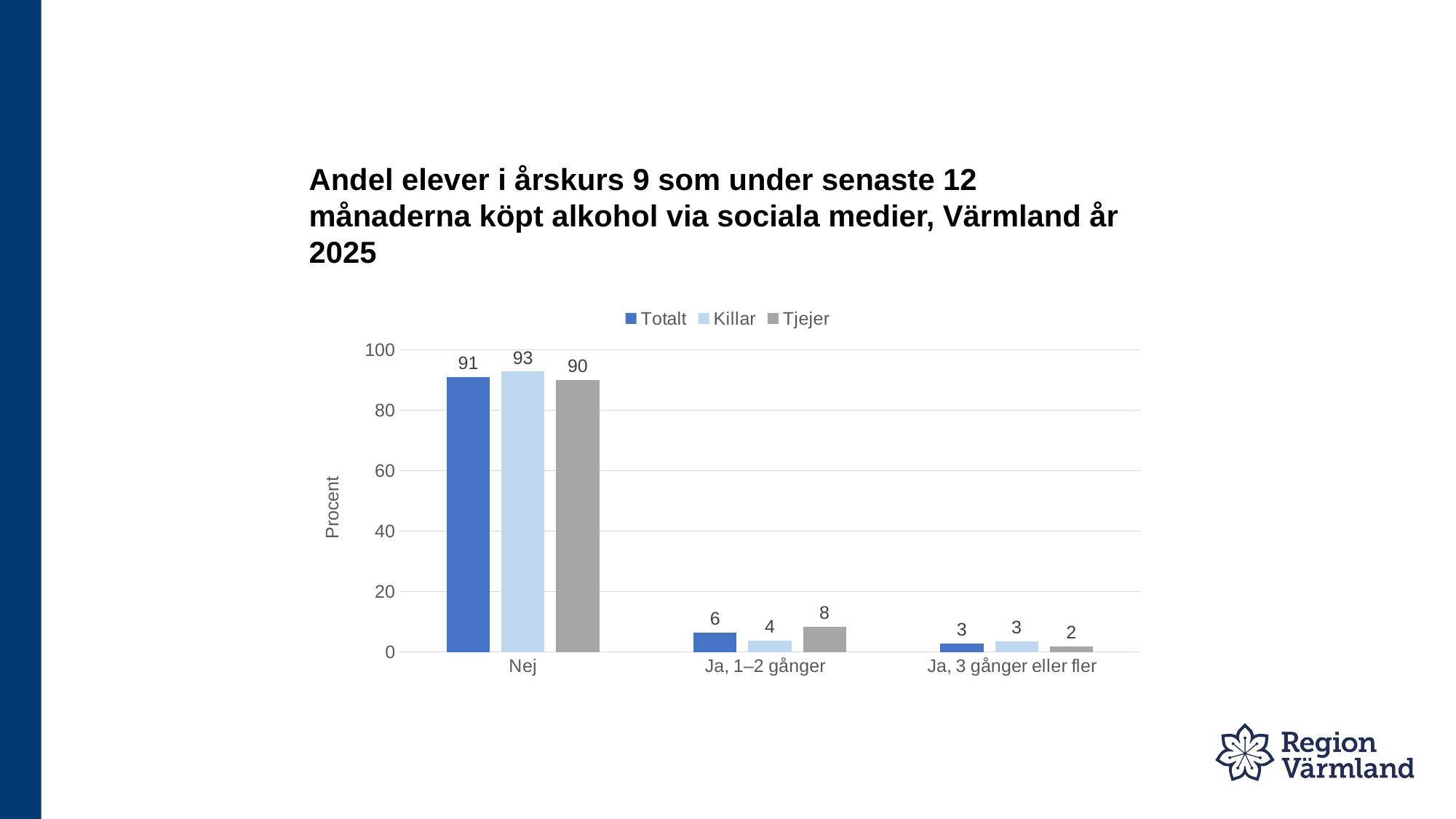
In the Ja, 1–2 gånger category, which is larger, Killar or Tjejer? Tjejer What kind of chart is shown on the slide? Bar chart How many series does the legend list? 3 What is the value for Totalt in the Nej category? 91 Which category has the lowest value for Tjejer? Ja, 3 gånger eller fler What is the value for Killar in the Nej category? 93 What is the label of the y axis? Procent How many categories are shown on the x axis? 3 What is the value for Tjejer in the Ja, 1–2 gånger category? 8 Which category has the highest value for Totalt? Nej What is the difference between the Killar and Tjejer values in the Nej category? 3 What is the value for Tjejer in the Ja, 3 gånger eller fler category? 2